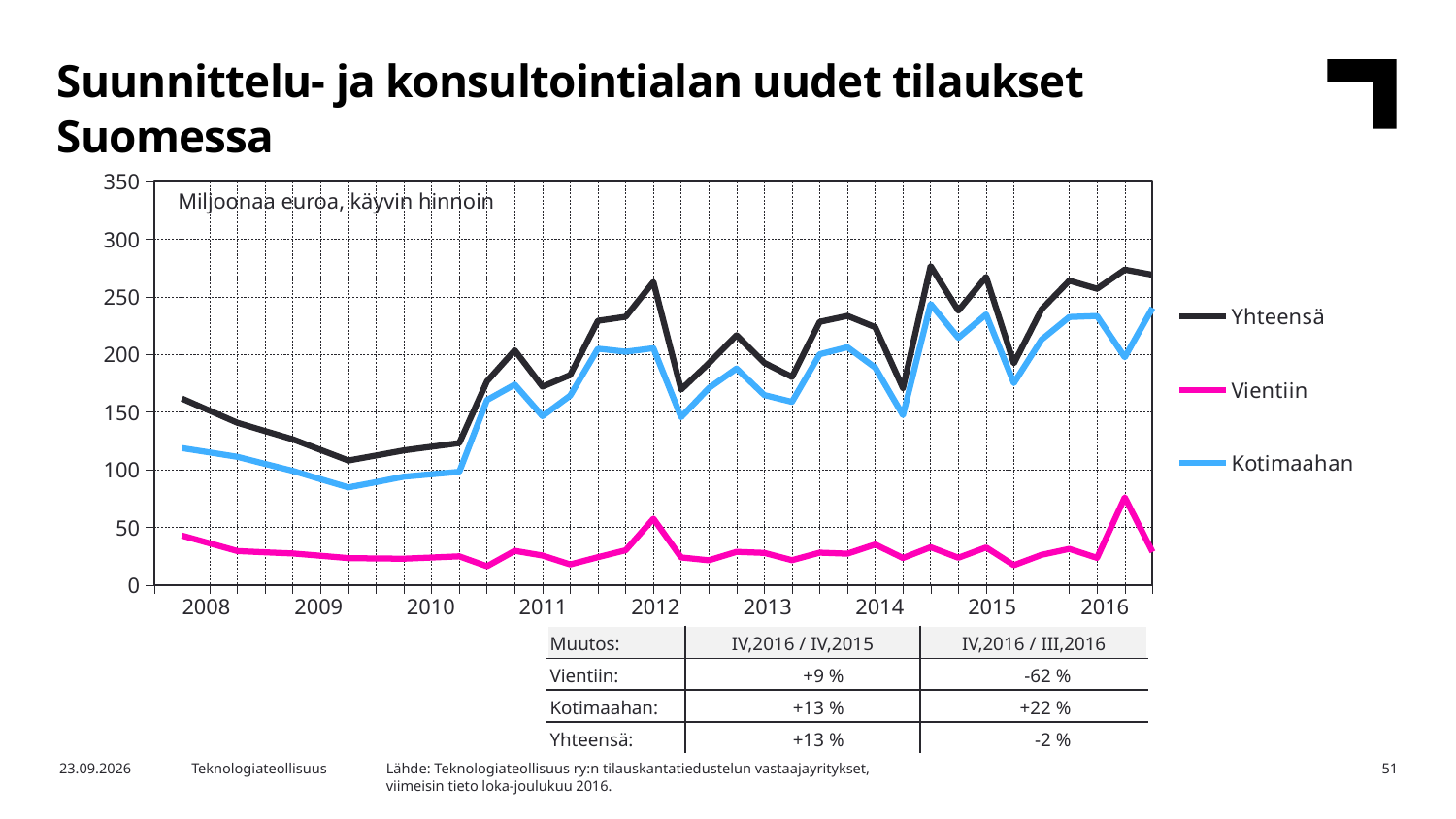
How many years are labelled on the x axis? 9 How many series does the legend list? 3 What unit is stated in the text inside the chart area? Miljoonaa euroa, käyvin hinnoin Is the highest value for Yhteensä in 2014 greater or less than 250? greater Which is larger at the start of 2012, Kotimaahan or Vientiin? Kotimaahan Is the value for Vientiin at the start of 2010 greater or less than 50? less Is the value for Kotimaahan at the start of 2008 greater or less than 100? greater Does the Yhteensä line rise or fall from 2008 to 2009? fall Which series has the highest values throughout the chart? Yhteensä What kind of chart is shown on the slide? line chart Which series has the lowest values throughout the chart? Vientiin What are the three series named in the legend? Yhteensä, Vientiin, Kotimaahan